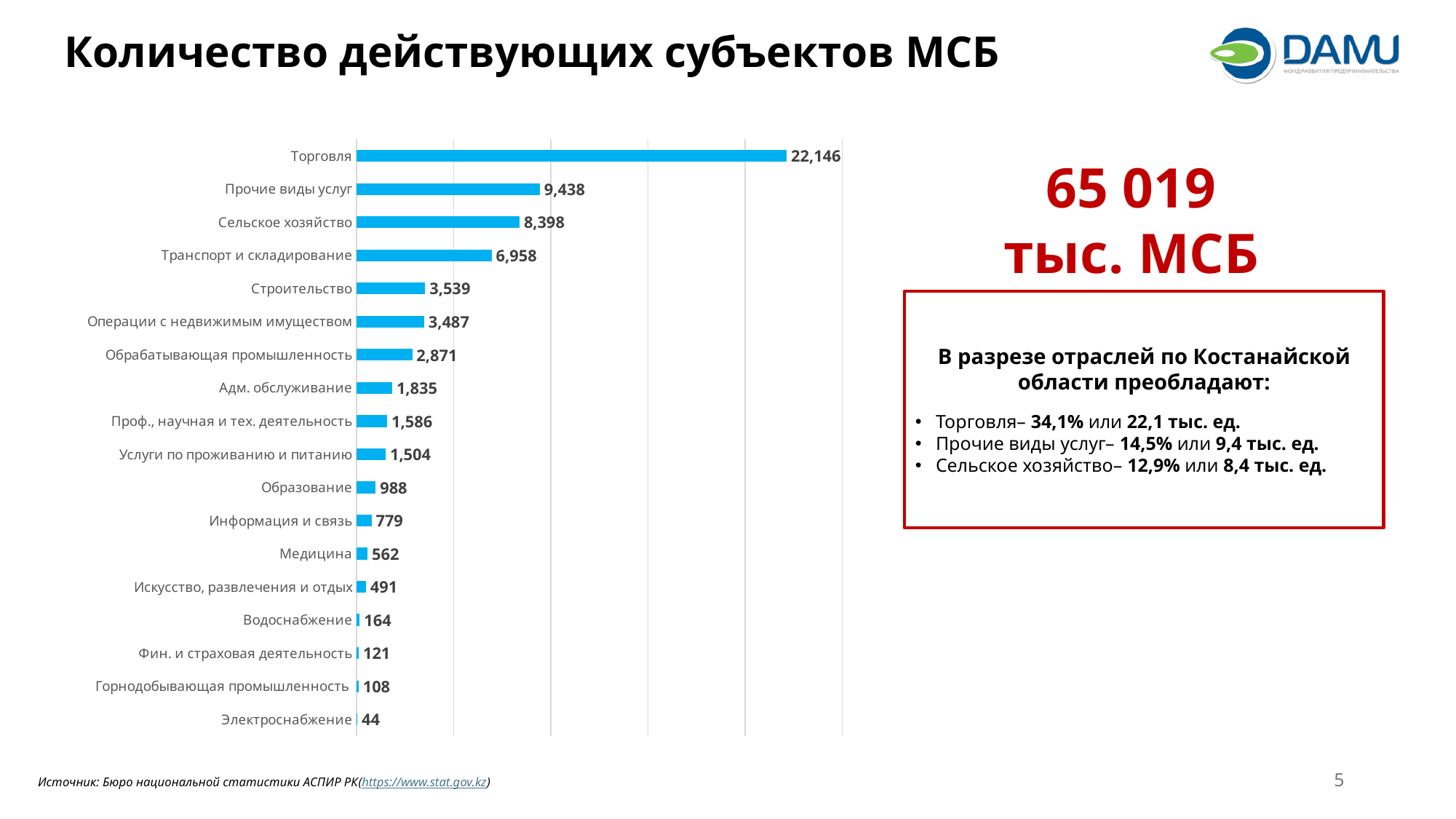
Which category has the highest value? Торговля What is the difference between the values for Строительство and Операции с недвижимым имуществом? 52 What kind of chart is shown on the slide? Bar chart What is the value for Сельское хозяйство? 8,398 How many categories are shown in the chart? 18 What is the value for Образование? 988 What is the value for Торговля? 22,146 What is the title of the slide? Количество действующих субъектов МСБ What is the value for Электроснабжение? 44 What is the difference between the values for Торговля and Прочие виды услуг? 12,708 Which is larger, the value for Медицина or the value for Искусство, развлечения и отдых? Медицина Which category has the lowest value? Электроснабжение